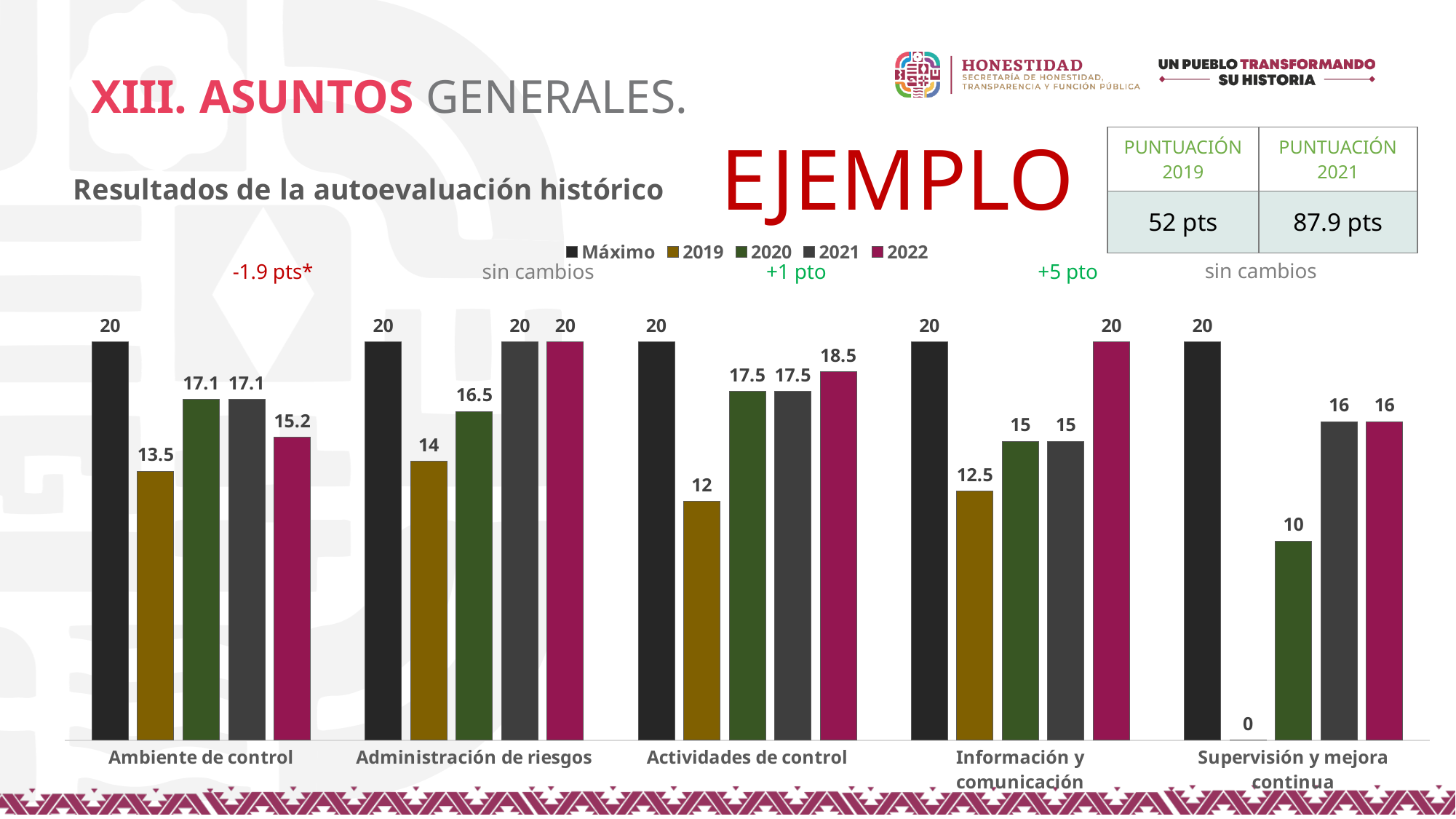
How many categories are shown on the x axis? 5 Which is larger for Ambiente de control: the 2021 value or the 2022 value? 2021 Which category has the highest 2020 value? Actividades de control What is the 2022 value for Actividades de control? 18.5 What is the difference between the 2022 value and the 2019 value for Información y comunicación? 7.5 What kind of chart is shown on the slide? Bar chart What is the 2019 value for Supervisión y mejora continua? 0 Which category has the lowest 2019 value? Supervisión y mejora continua What is the title of the chart? Resultados de la autoevaluación histórico How many series does the legend list? 5 What is the 2020 value for Supervisión y mejora continua? 10 What is the 2019 value for Ambiente de control? 13.5